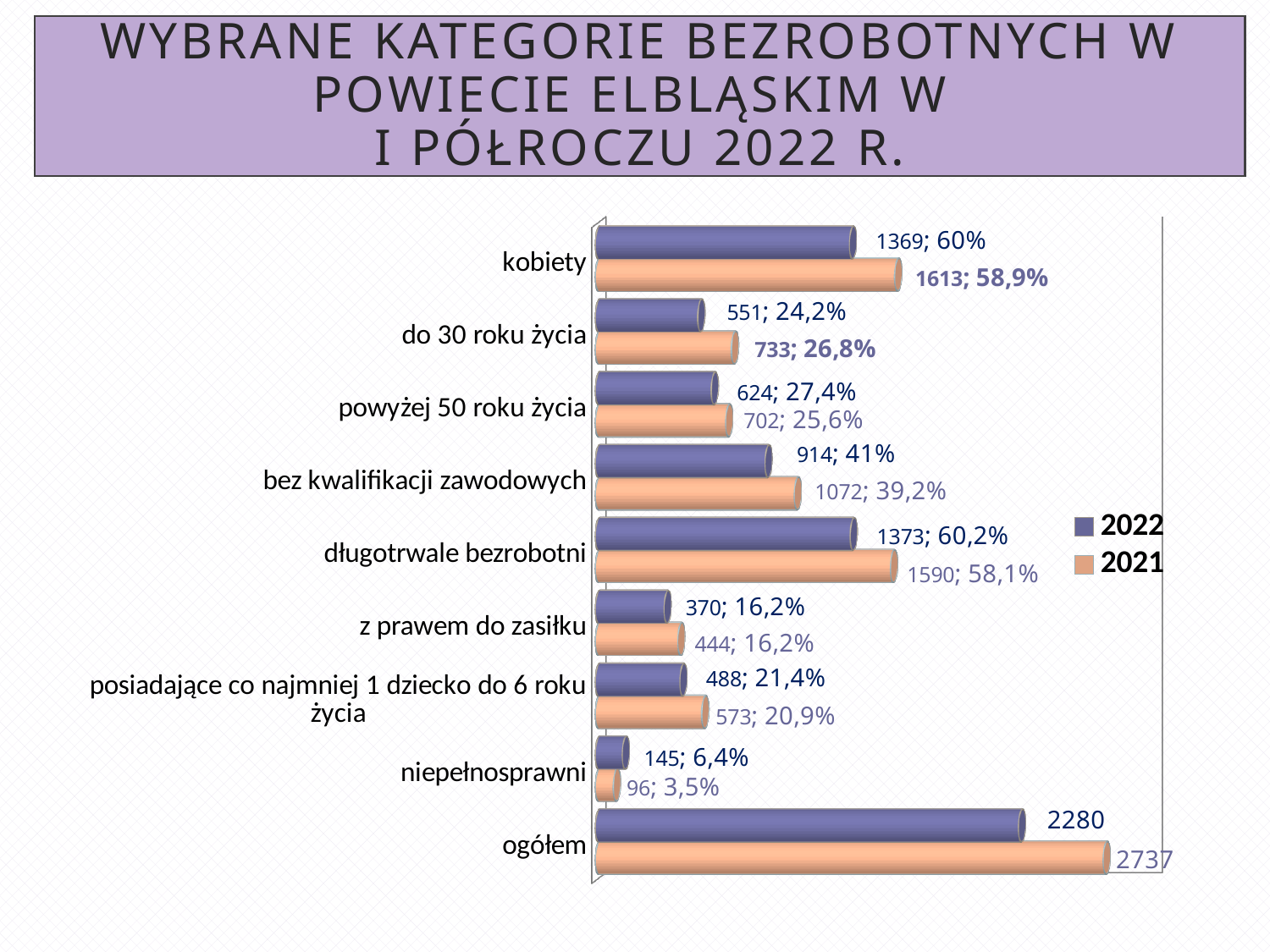
How many categories are shown on the chart? 9 What is the value for 'kobiety' in the 2022 series? 1369; 60% Which category has the lowest value in the 2022 series? niepełnosprawni What kind of chart is shown on the slide? bar chart Which category has the highest value in the 2021 series? ogółem How many series does the legend list? 2 Which is larger for 'niepełnosprawni': the 2022 value or the 2021 value? 2022 What is the value for 'niepełnosprawni' in the 2021 series? 96; 3,5% What is the value for 'ogółem' in the 2021 series? 2737 Which series is shown in orange according to the legend? 2021 What is the value for 'długotrwale bezrobotni' in the 2022 series? 1373; 60,2% What is the difference between the 2021 and 2022 values for 'ogółem'? 457